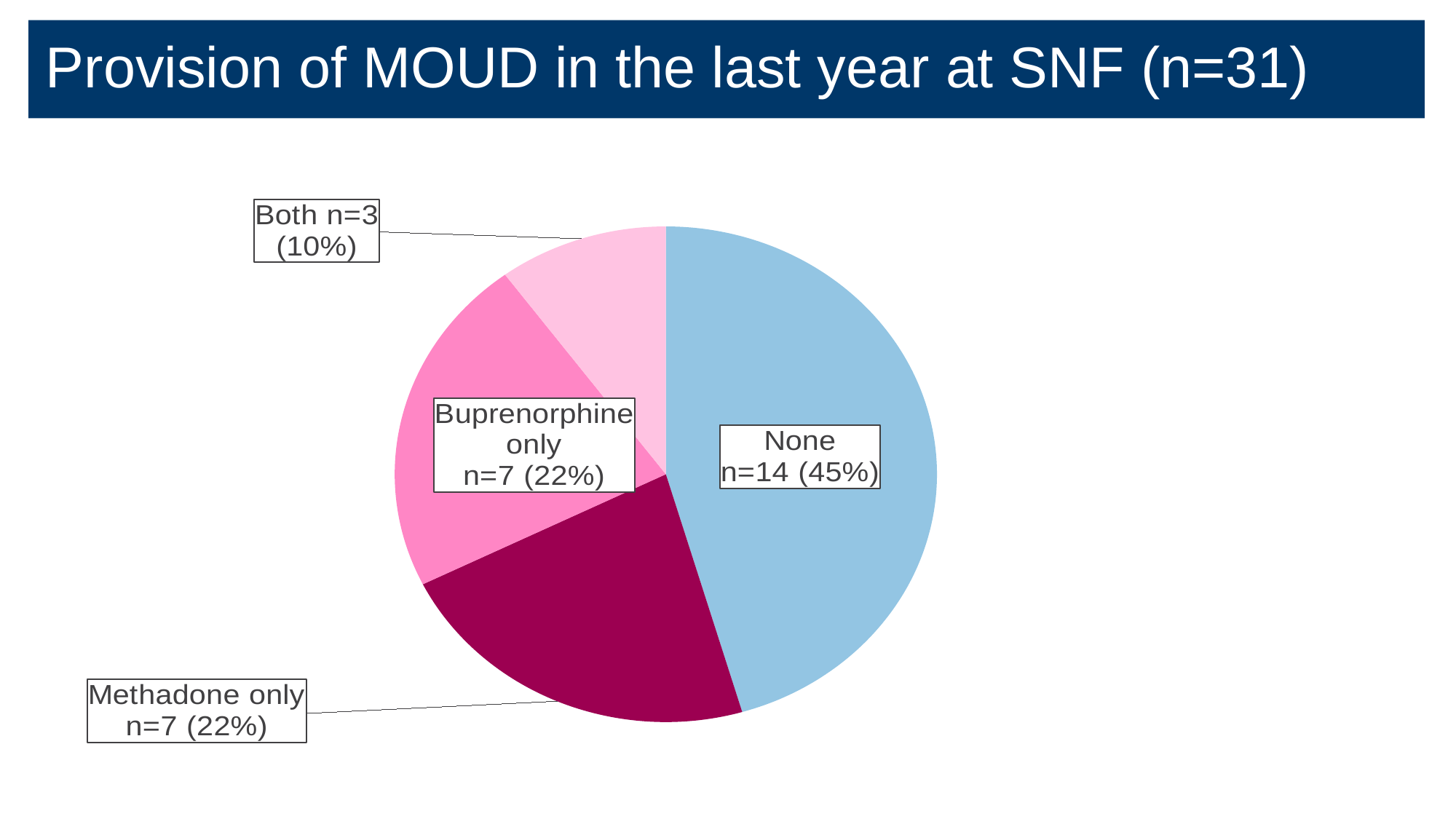
How many slices does the pie chart have? 4 What percentage of the pie does the Methadone only slice represent? 22% What is the title of the chart? Provision of MOUD in the last year at SNF (n=31) Which is larger, the count for Buprenorphine only or the count for Both? Buprenorphine only What percentage of the pie does the Both slice represent? 10% Which category has the smallest slice? Both What percentage of the pie does the None slice represent? 45% What is the count (n) for the None slice? n=14 What kind of chart is shown on the slide? pie chart Which category has the largest slice? None What is the count (n) for the Both slice? n=3 What is the difference in count between None and Both? 11